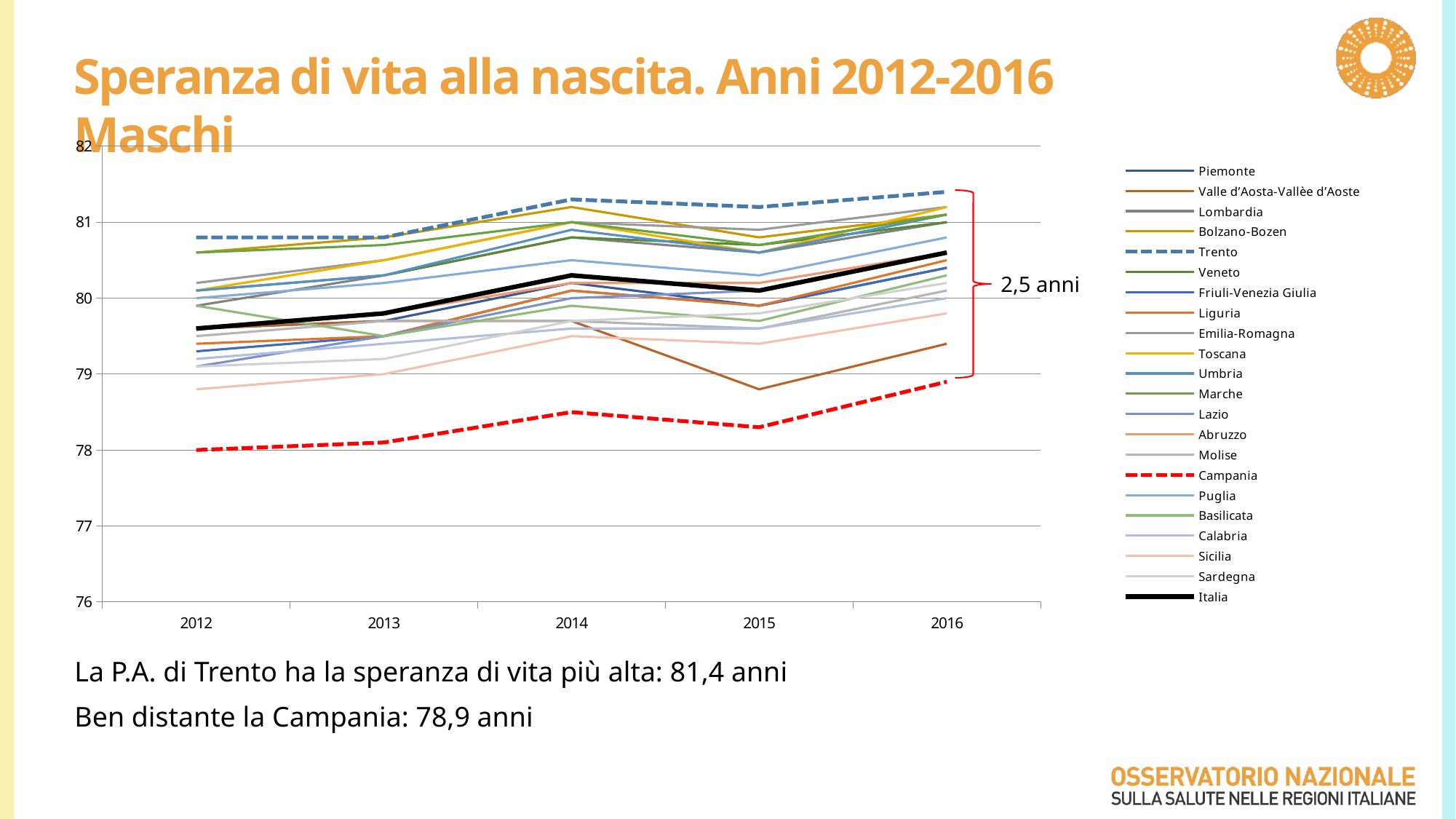
What is the life expectancy at birth for Campania in 2016? 78,9 anni Is the value for Trento in 2014 greater or less than 81? greater Which is larger in 2016, the value for Trento or the value for Campania? Trento How many years are shown on the x axis? 5 How many series does the legend list? 22 Is the value for Campania in 2015 greater or less than 79? less Which region has the highest life expectancy in 2016? Trento What is the life expectancy at birth for Trento in 2016? 81,4 anni What kind of chart is shown on the slide? line chart Does the Campania line rise or fall overall from 2012 to 2016? rise What is the difference between Trento and Campania in 2016? 2,5 anni Which region has the lowest life expectancy in 2016? Campania